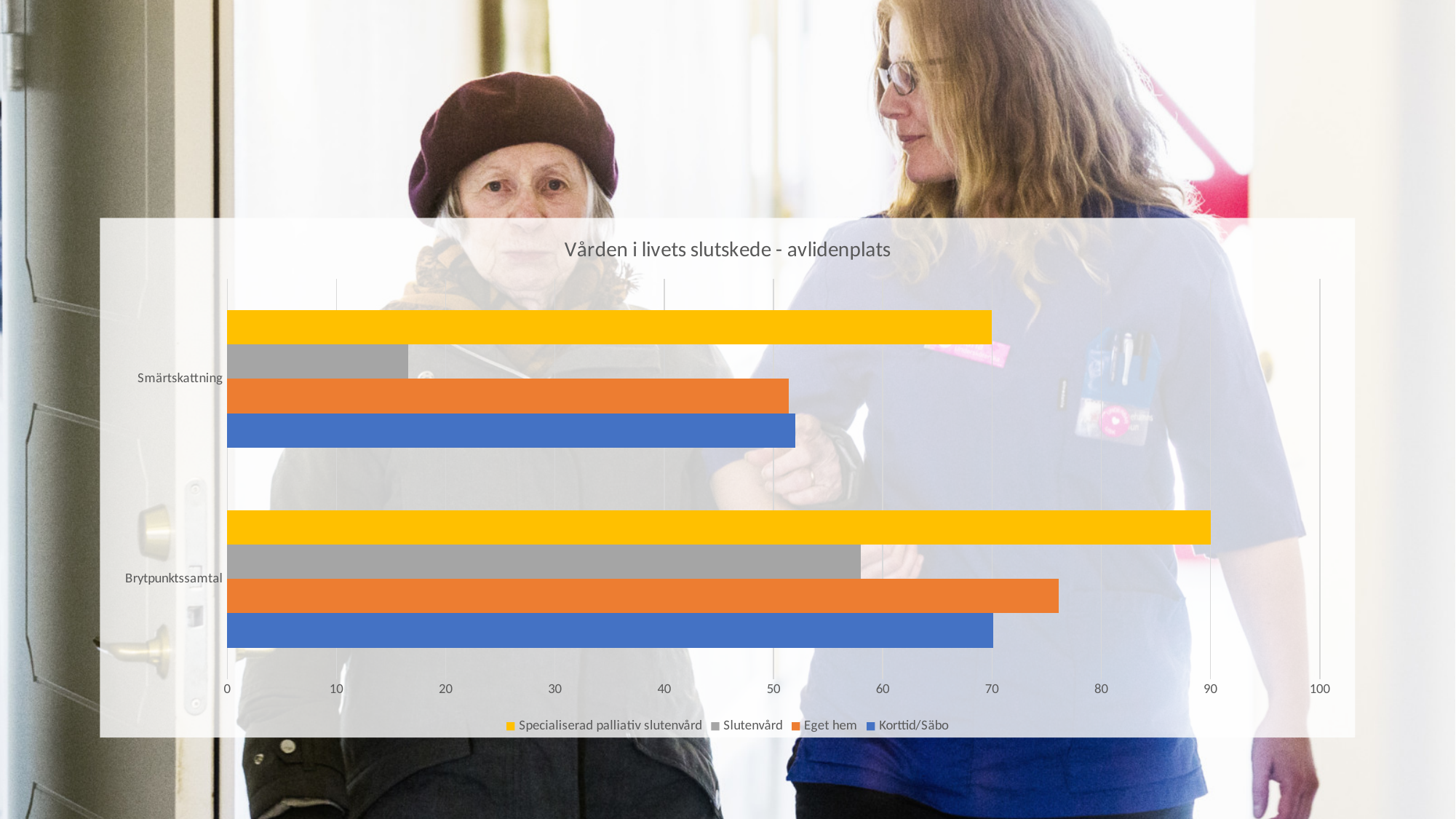
How many series does the legend list? 4 For Specialiserad palliativ slutenvård, which category has the larger value: Smärtskattning or Brytpunktssamtal? Brytpunktssamtal Which colour represents the Eget hem series? orange What is the title of the chart? Vården i livets slutskede - avlidenplats Is the value for Slutenvård in Smärtskattning greater or less than 20? less For Brytpunktssamtal, which is larger: Eget hem or Korttid/Säbo? Eget hem How many categories are shown on the vertical axis? 2 Which series has the lowest value for Smärtskattning? Slutenvård Is the value for Eget hem in Brytpunktssamtal greater or less than 70? greater What kind of chart is shown on the slide? bar chart Which series has the highest value for Brytpunktssamtal? Specialiserad palliativ slutenvård Is the value for Slutenvård in Brytpunktssamtal greater or less than 60? less